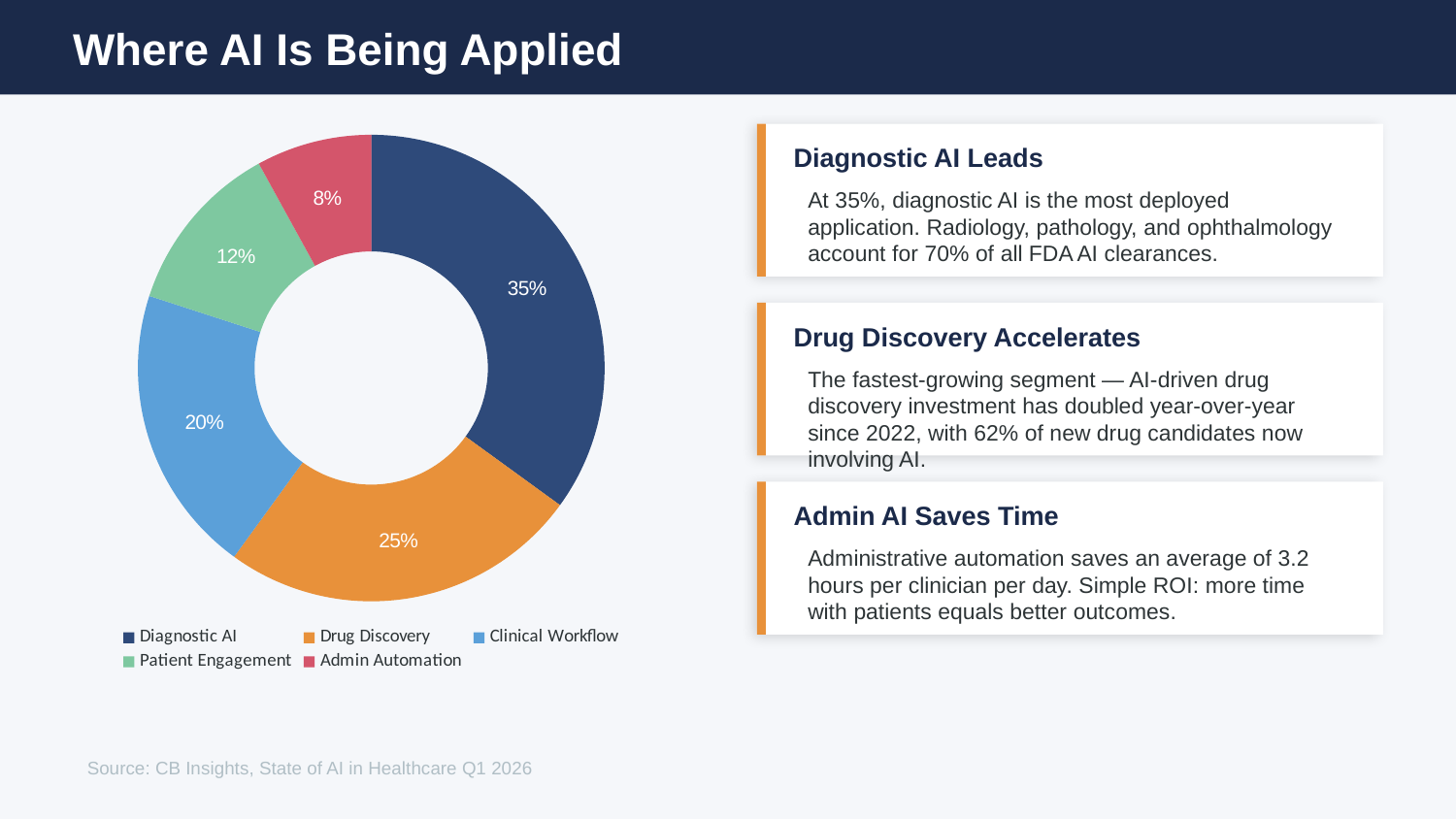
How many categories are shown in the pie chart? 5 Which category has the largest slice of the pie? Diagnostic AI What percentage is shown for Clinical Workflow? 20% Which category has the smallest slice of the pie? Admin Automation What colour is the Drug Discovery slice? Orange What is the value shown for Drug Discovery? 25% Which is larger, Clinical Workflow or Patient Engagement? Clinical Workflow What is the value for Patient Engagement? 12% What is the difference between the Diagnostic AI and Drug Discovery shares? 10% What kind of chart is shown on the slide? Pie chart (doughnut) What share of the pie does Diagnostic AI account for? 35% What is the value for Admin Automation? 8%